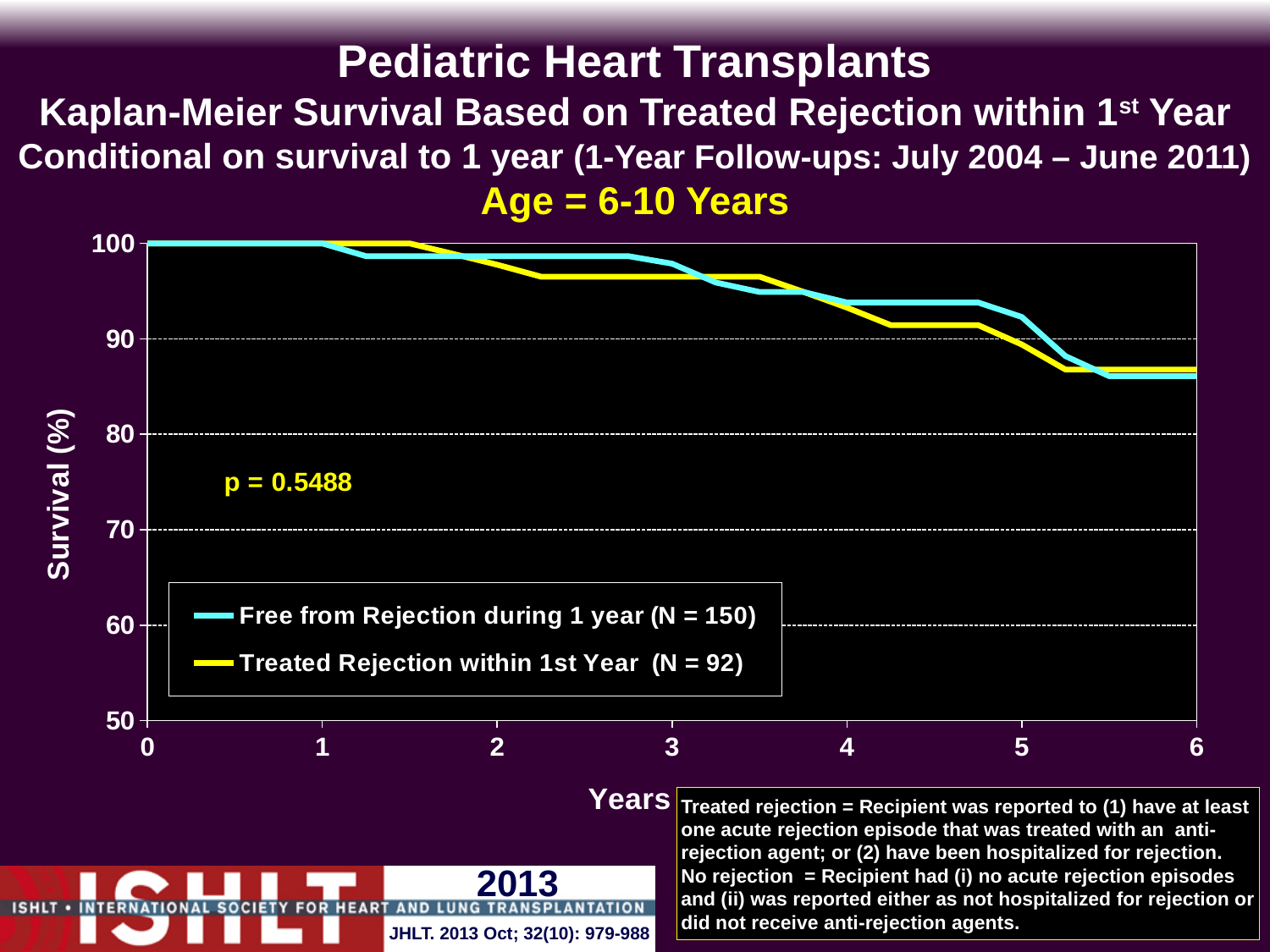
What is the N for the 'Free from Rejection during 1 year' group shown in the legend? 150 Is the survival value for the 'Free from Rejection during 1 year' group at 3 years greater or less than 90? greater How many series does the legend list? 2 What kind of chart is shown on the slide? Line chart What is the maximum value shown on the y axis (Survival %)? 100 Do the survival curves rise or fall as years increase along the x axis? Fall Is the survival value for the 'Treated Rejection within 1st Year' group at 6 years greater or less than 80? greater What is the N for the 'Treated Rejection within 1st Year' group shown in the legend? 92 What is the maximum value shown on the x axis (Years)? 6 Is the survival value for the 'Treated Rejection within 1st Year' group at 4 years greater or less than 90? greater